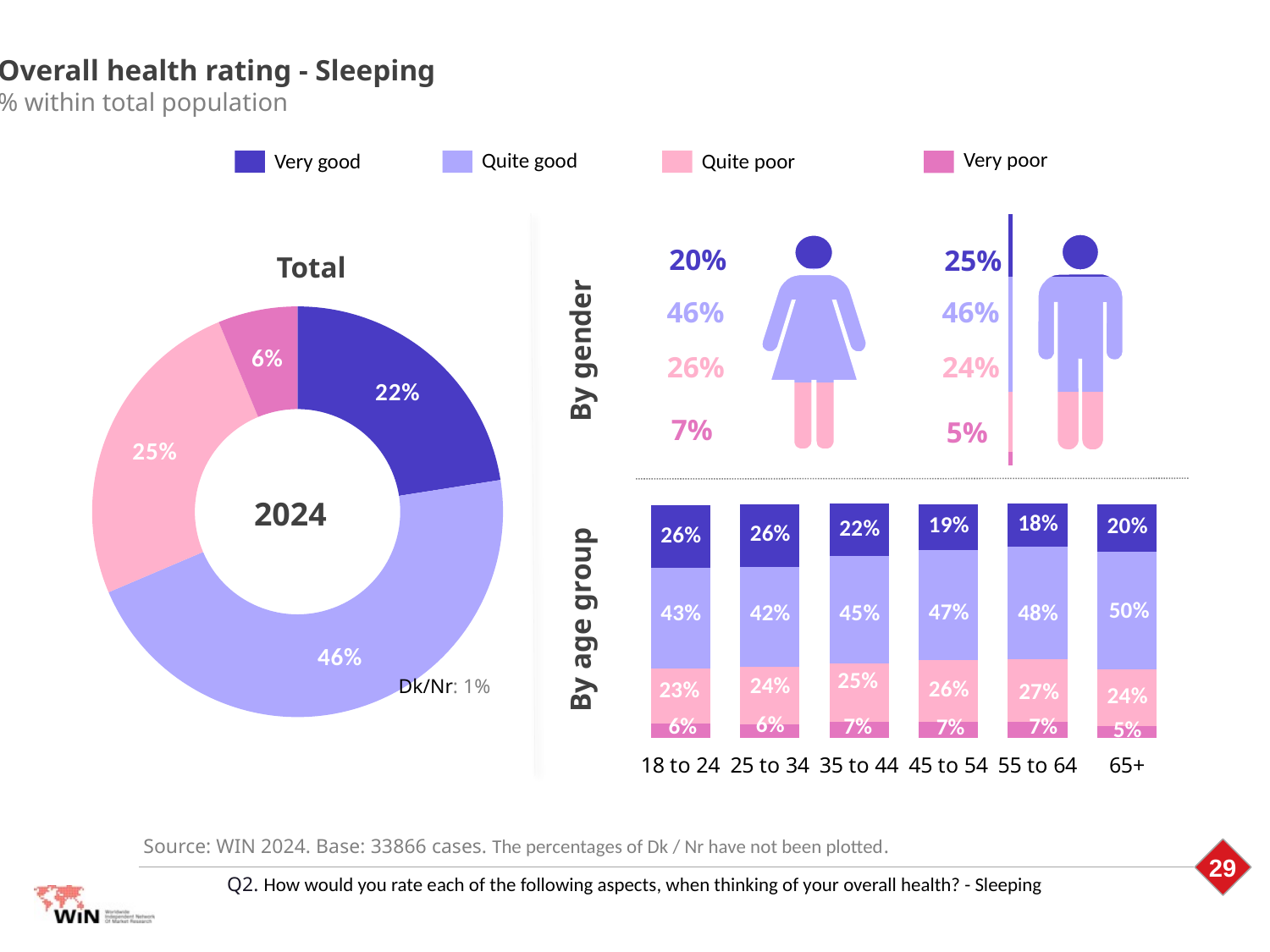
In the Total donut chart, what is the difference between the Quite poor share and the Very good share? 3% In the By gender section, which gender has the higher Quite poor percentage? Women (26%) In the By age group bar chart, what is the total of the four plotted segments for the 45 to 54 group? 99% In the By gender section, what percentage of men rated their sleeping as Very good? 25% In the By age group bar chart, what is the Quite good value for the 65+ group? 50% In the By age group bar chart, how many age groups are shown? 6 In the By age group bar chart, does the Quite good value rise or fall from 25 to 34 through 65+? Rises In the Total donut chart, what share of respondents rated their sleeping as Quite good? 46% In the By age group bar chart, which age group has the highest Very good value? 18 to 24 and 25 to 34 (both 26%) How many rating categories does the legend at the top of the slide list? 4 What kind of chart is the Total chart on the left of the slide? Donut (pie) chart In the Total donut chart, which rating has the smallest share? Very poor